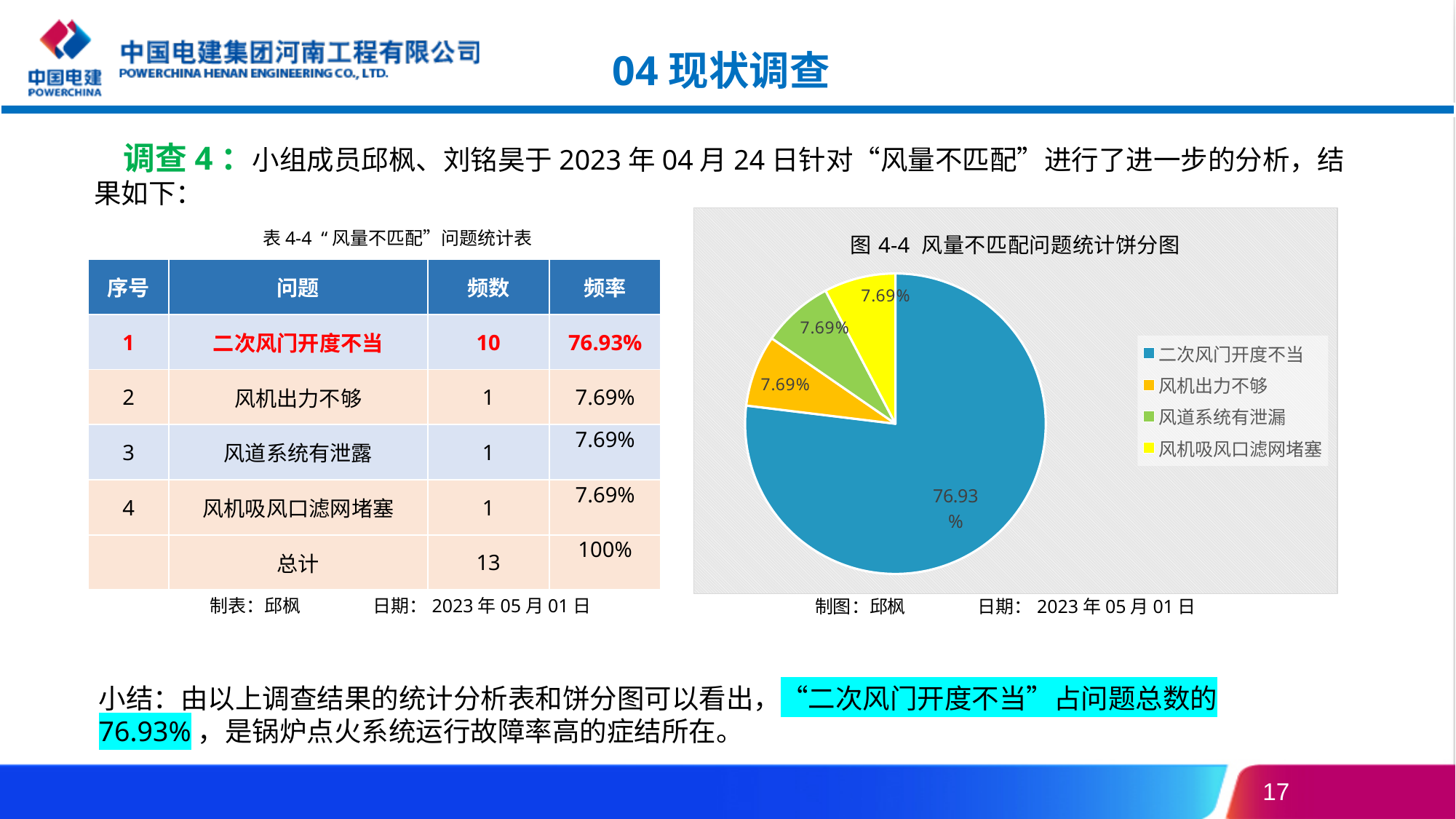
Which is larger in the pie chart, 二次风门开度不当 or 风机出力不够? 二次风门开度不当 Which category is shown in yellow in the pie chart? 风机吸风口滤网堵塞 What kind of chart is shown on the slide? pie chart How many slices does the pie chart have? 4 Which category has the largest slice in the pie chart? 二次风门开度不当 What is the value shown for 风机出力不够 in the pie chart? 7.69% What is the value shown for 风道系统有泄漏 in the pie chart? 7.69% How many entries does the legend of the pie chart list? 4 What is the value shown for 风机吸风口滤网堵塞 in the pie chart? 7.69% What is the difference in percentage points between the 二次风门开度不当 slice and the 风机出力不够 slice? 69.24% What is the title of the pie chart? 图 4-4 风量不匹配问题统计饼分图 What share of the pie does 二次风门开度不当 account for? 76.93%